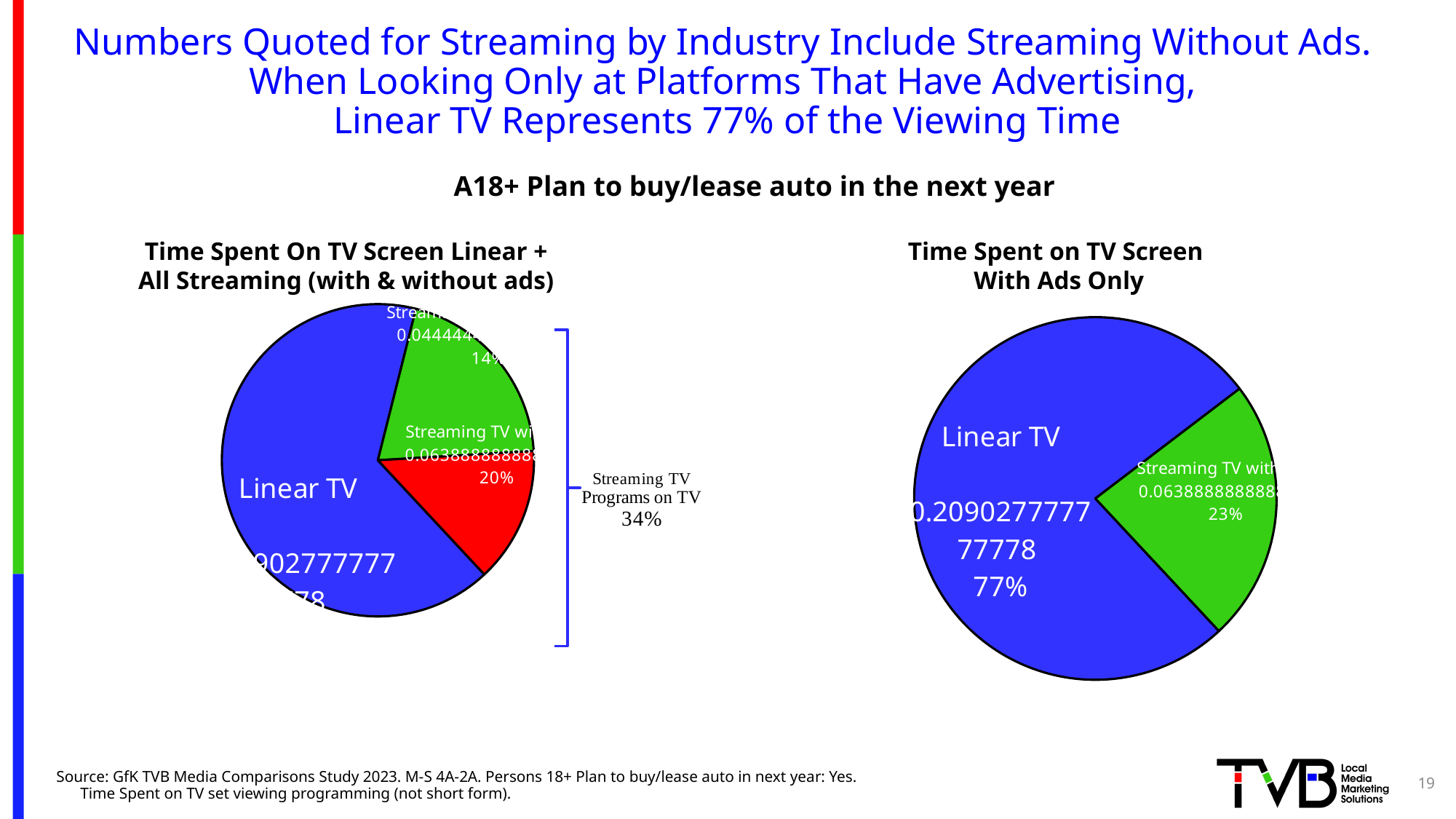
On the 'Time Spent on TV Screen With Ads Only' chart, what colour is the Linear TV slice? Blue On the left chart ('Time Spent On TV Screen Linear + All Streaming'), what combined percentage is shown by the bracket for Streaming TV Programs on TV? 34% On the 'Time Spent on TV Screen With Ads Only' chart, how many slices does the pie have? 2 On the 'Time Spent on TV Screen With Ads Only' chart, what percentage is shown for Streaming TV with ads? 23% On the 'Time Spent on TV Screen With Ads Only' chart, which category has the smallest share? Streaming TV with ads What audience segment is named in the subtitle above the two charts? A18+ Plan to buy/lease auto in the next year On the 'Time Spent on TV Screen With Ads Only' chart, what percentage is shown for Linear TV? 77% On the left chart ('Time Spent On TV Screen Linear + All Streaming'), how many slices does the pie have? 3 What type of chart is used for 'Time Spent on TV Screen With Ads Only'? Pie chart On the 'Time Spent on TV Screen With Ads Only' chart, what is the difference in percentage points between Linear TV and Streaming TV with ads? 54 On the left chart ('Time Spent On TV Screen Linear + All Streaming'), which category has the largest share? Linear TV On the 'Time Spent on TV Screen With Ads Only' chart, which category has the largest share? Linear TV